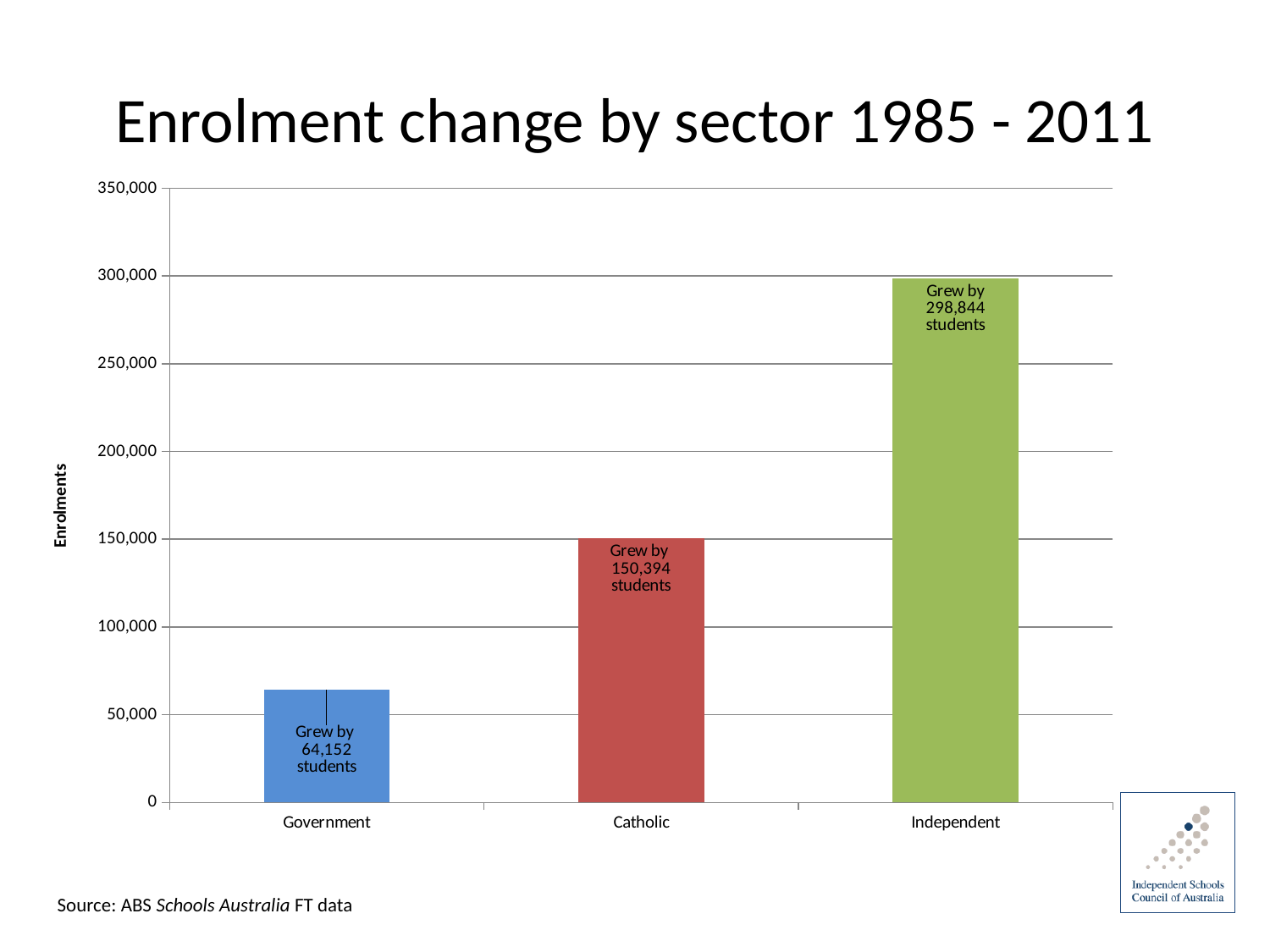
What is the difference in enrolment growth between the Independent and Catholic sectors? 148,450 By how many students did Catholic sector enrolments grow between 1985 and 2011? 150,394 By how many students did Government sector enrolments grow between 1985 and 2011? 64,152 Which sector had the largest enrolment growth? Independent By how many students did Independent sector enrolments grow between 1985 and 2011? 298,844 What type of chart is shown on the slide? Bar chart Which sector had the smallest enrolment growth? Government Is the enrolment growth for the Independent sector greater or less than 250,000? greater What is the label on the vertical axis of the chart? Enrolments What is the difference in enrolment growth between the Catholic and Government sectors? 86,242 Which sector grew by more students, Catholic or Government? Catholic How many sectors are shown in the chart? 3